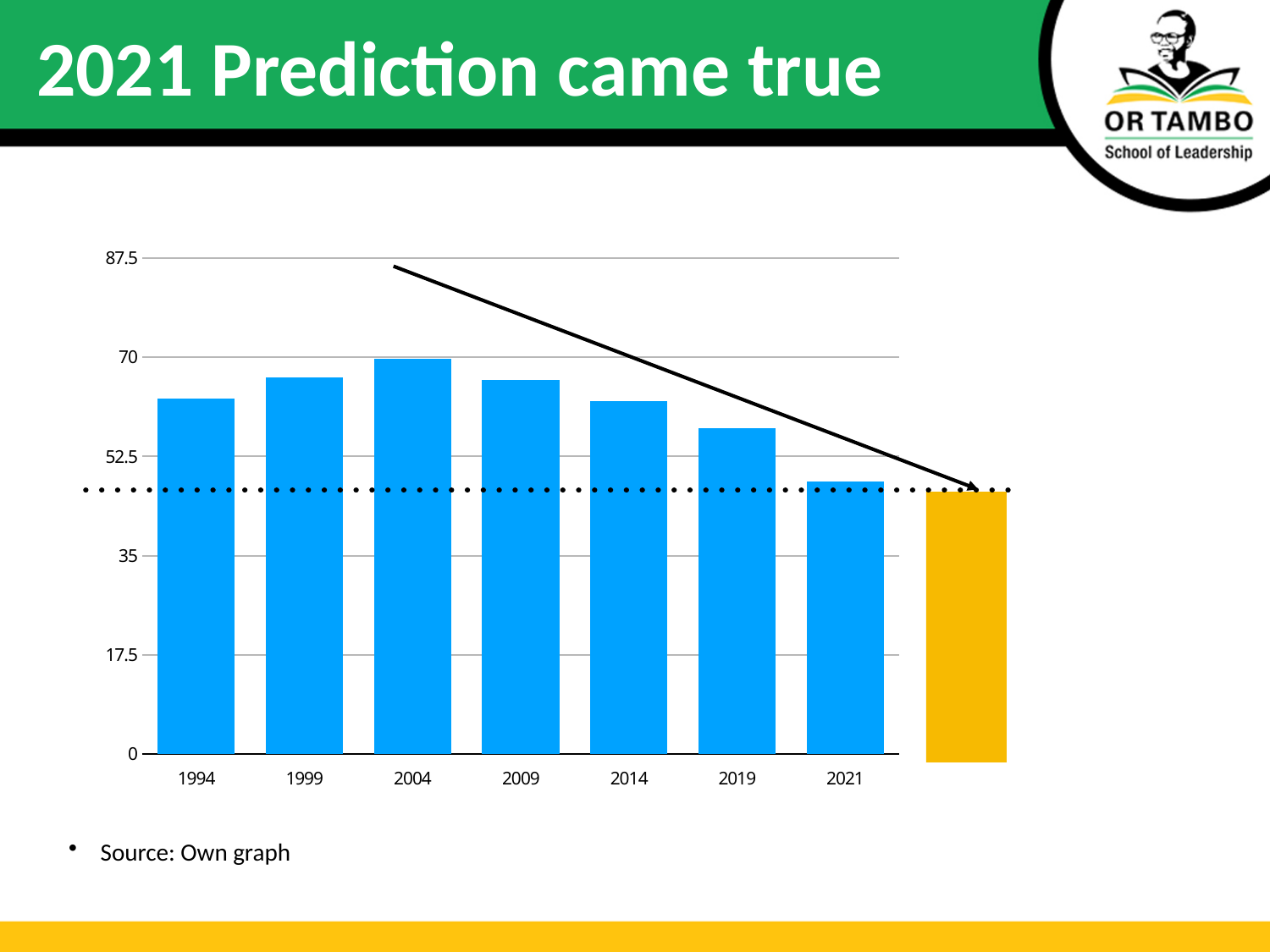
Is the value for 2019 greater or less than 52.5? greater Is the value for 2021 greater or less than 52.5? less What kind of chart is shown on the slide? bar chart Which year has the highest bar in the chart? 2004 Do the bar values rise or fall from 2004 to 2021? fall Is the value for 1999 greater or less than 70? less How many labelled years are shown on the x axis of the chart? 7 Which is larger, the value for 1999 or the value for 2019? 1999 What is the title of the slide containing the chart? 2021 Prediction came true Which is larger, the value for 2004 or the value for 2021? 2004 Which labelled year has the lowest bar in the chart? 2021